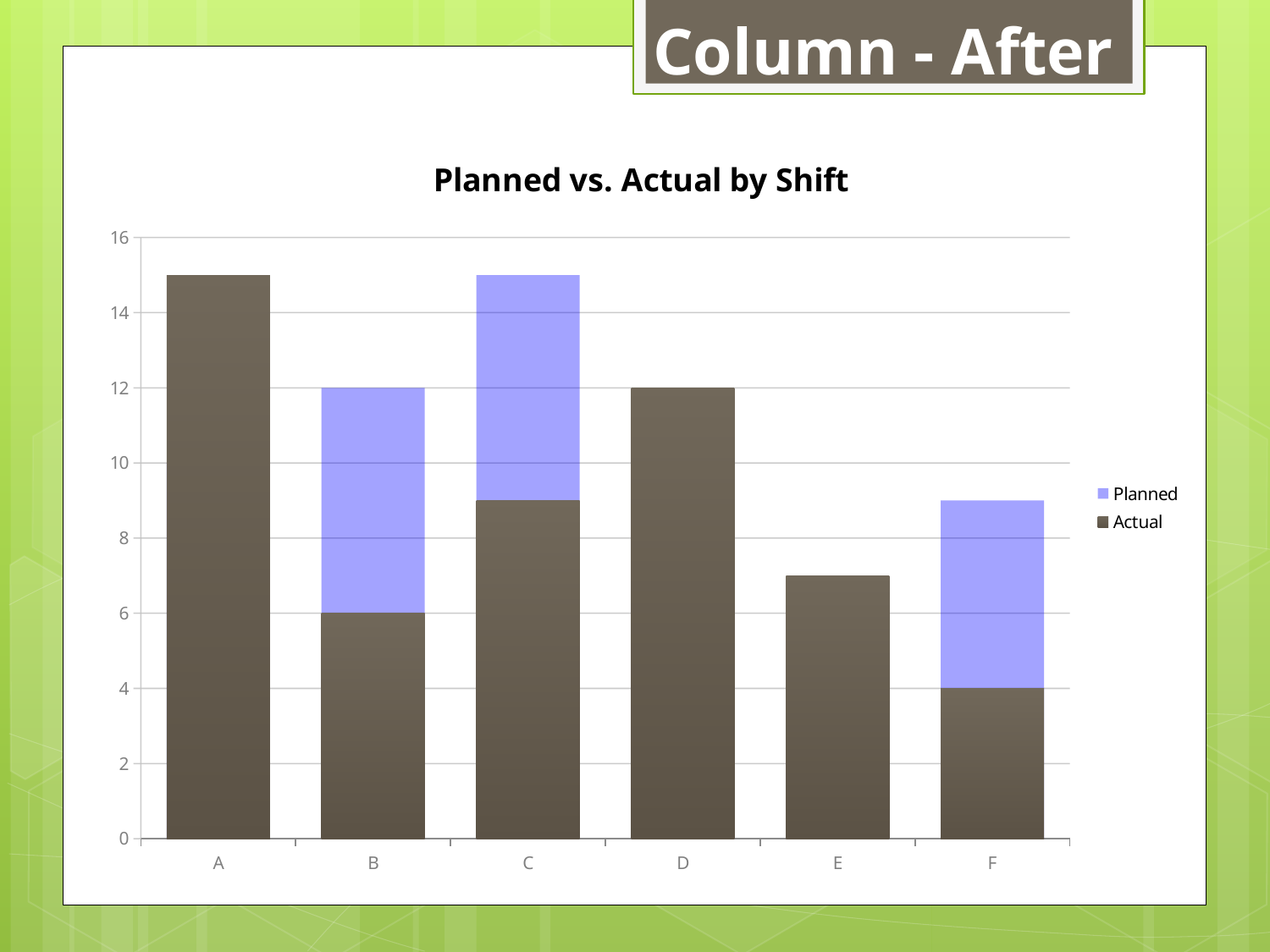
Which shift has the highest Actual value? A What is the Planned value for shift B? 12 What kind of chart is shown on the slide? bar chart How many shifts (categories) are shown on the x axis? 6 What is the Actual value for shift F? 4 How many series does the legend list? 2 Is the Actual value for shift A greater or less than 14? greater Is the Planned value for shift C greater or less than 14? greater Which shift has the lowest Actual value? F What is the Actual value for shift D? 12 What is the Actual value for shift B? 6 What is the difference between the Planned and Actual values for shift B? 6